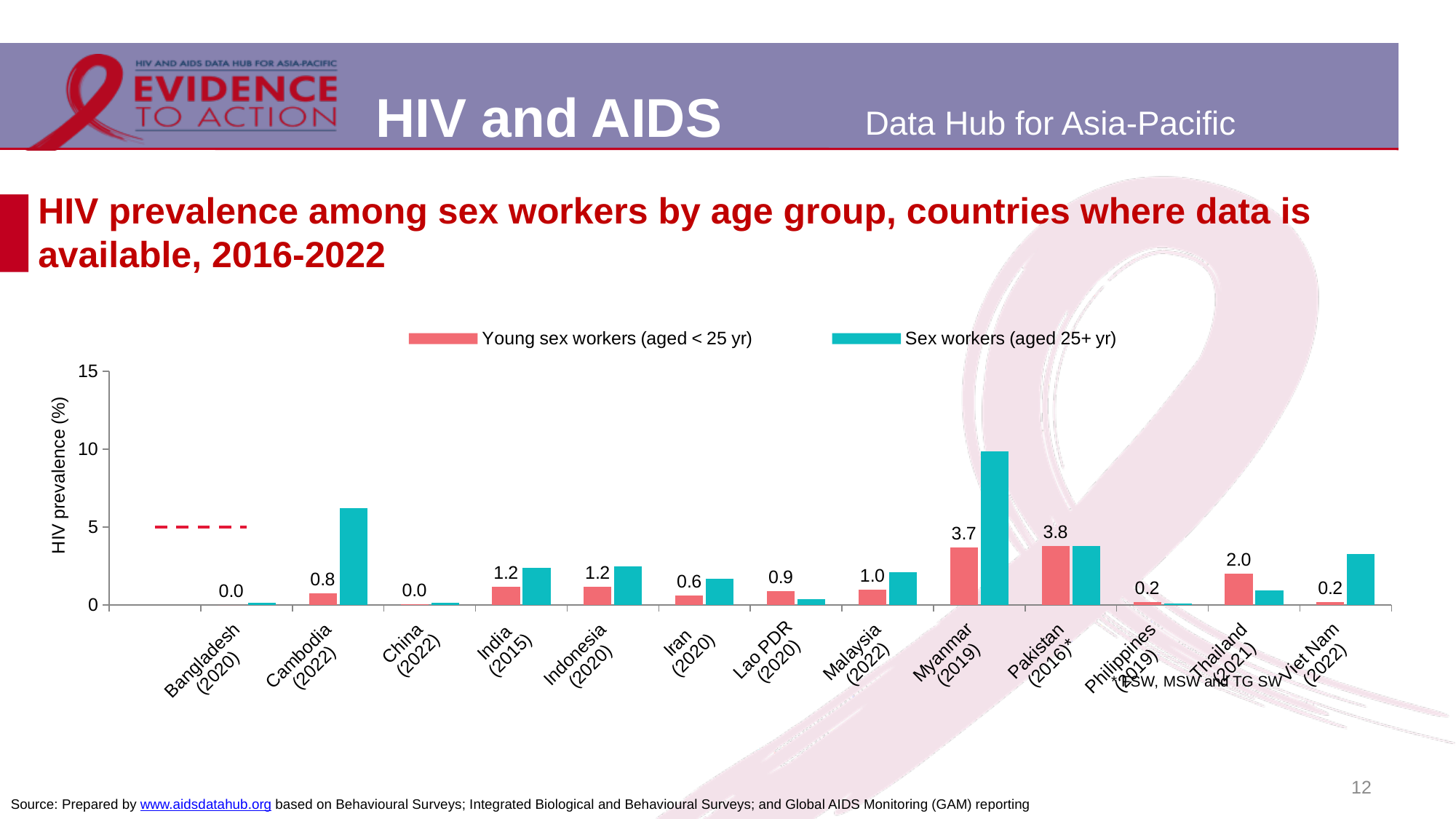
What is the HIV prevalence among young sex workers (aged < 25 yr) in Lao PDR (2020)? 0.9 How many countries are shown on the x axis of the chart? 13 Is the value for sex workers (aged 25+ yr) in Myanmar (2019) greater or less than 5? greater What is the HIV prevalence among young sex workers (aged < 25 yr) in Thailand (2021)? 2.0 How many series does the legend list? 2 What is the difference between the young sex worker (aged < 25 yr) values for Thailand (2021) and Cambodia (2022)? 1.2 Which is larger for young sex workers (aged < 25 yr): Thailand (2021) or Malaysia (2022)? Thailand (2021) What kind of chart is shown on the slide? Bar chart What is the difference between the young sex worker (aged < 25 yr) values for Pakistan (2016)* and Myanmar (2019)? 0.1 What is the HIV prevalence among young sex workers (aged < 25 yr) in Myanmar (2019)? 3.7 Which country has the highest HIV prevalence among young sex workers (aged < 25 yr)? Pakistan (2016)* Is the value for sex workers (aged 25+ yr) in Viet Nam (2022) greater or less than 5? less